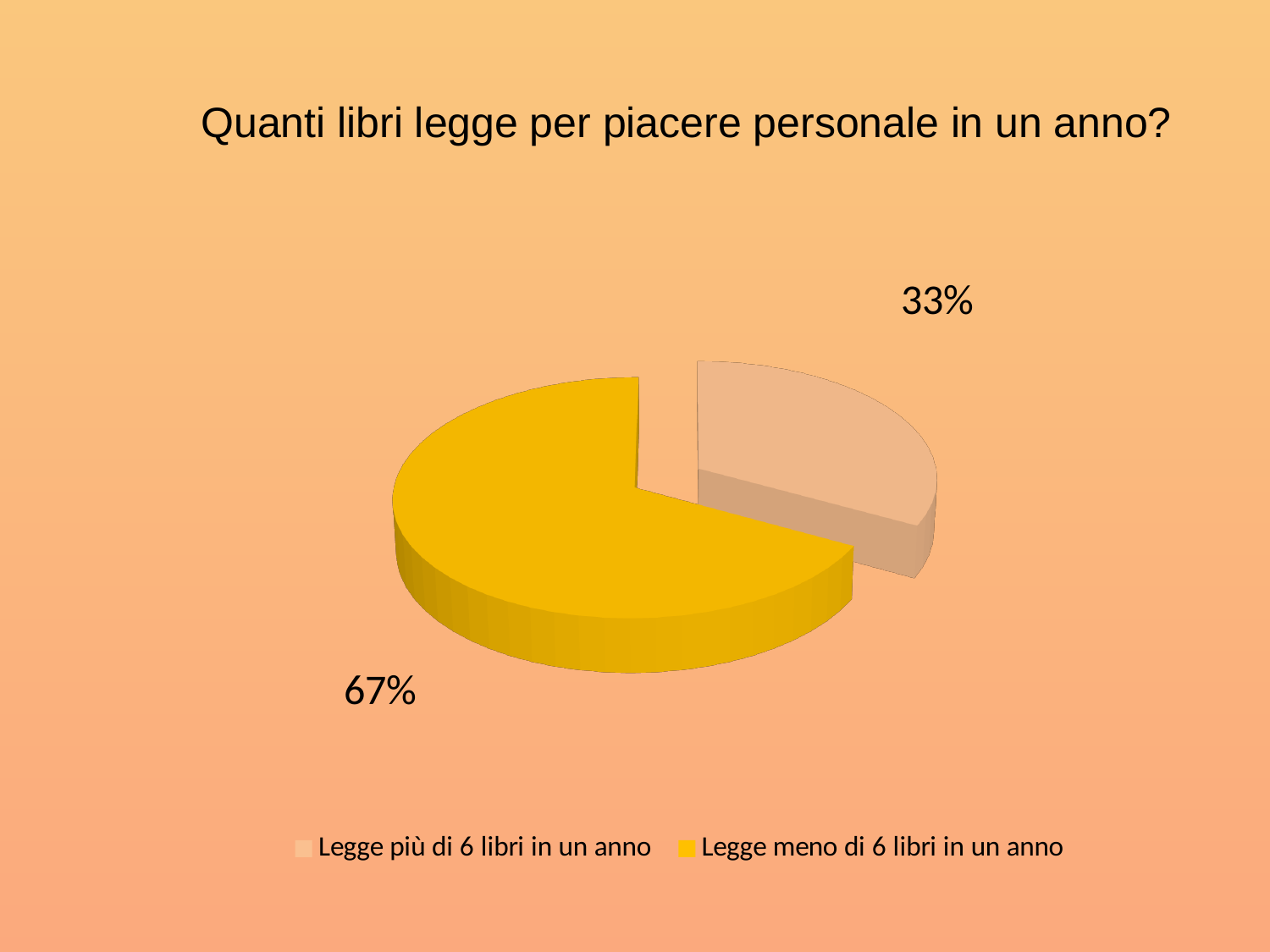
How many slices does the pie chart have? 2 What share of the pie is labelled "Legge più di 6 libri in un anno"? 33% What share of the pie is labelled "Legge meno di 6 libri in un anno"? 67% How many entries does the legend list? 2 What colour is the slice for "Legge meno di 6 libri in un anno"? yellow What kind of chart is shown on the slide? pie chart Which category has the smallest slice of the pie? Legge più di 6 libri in un anno What is the difference in percentage points between the "Legge meno di 6 libri in un anno" slice and the "Legge più di 6 libri in un anno" slice? 34 What is the title of the chart? Quanti libri legge per piacere personale in un anno? Which category has the largest slice of the pie? Legge meno di 6 libri in un anno Which is larger: the share for "Legge più di 6 libri in un anno" or the share for "Legge meno di 6 libri in un anno"? Legge meno di 6 libri in un anno Is the share for "Legge più di 6 libri in un anno" greater or less than 50%? less